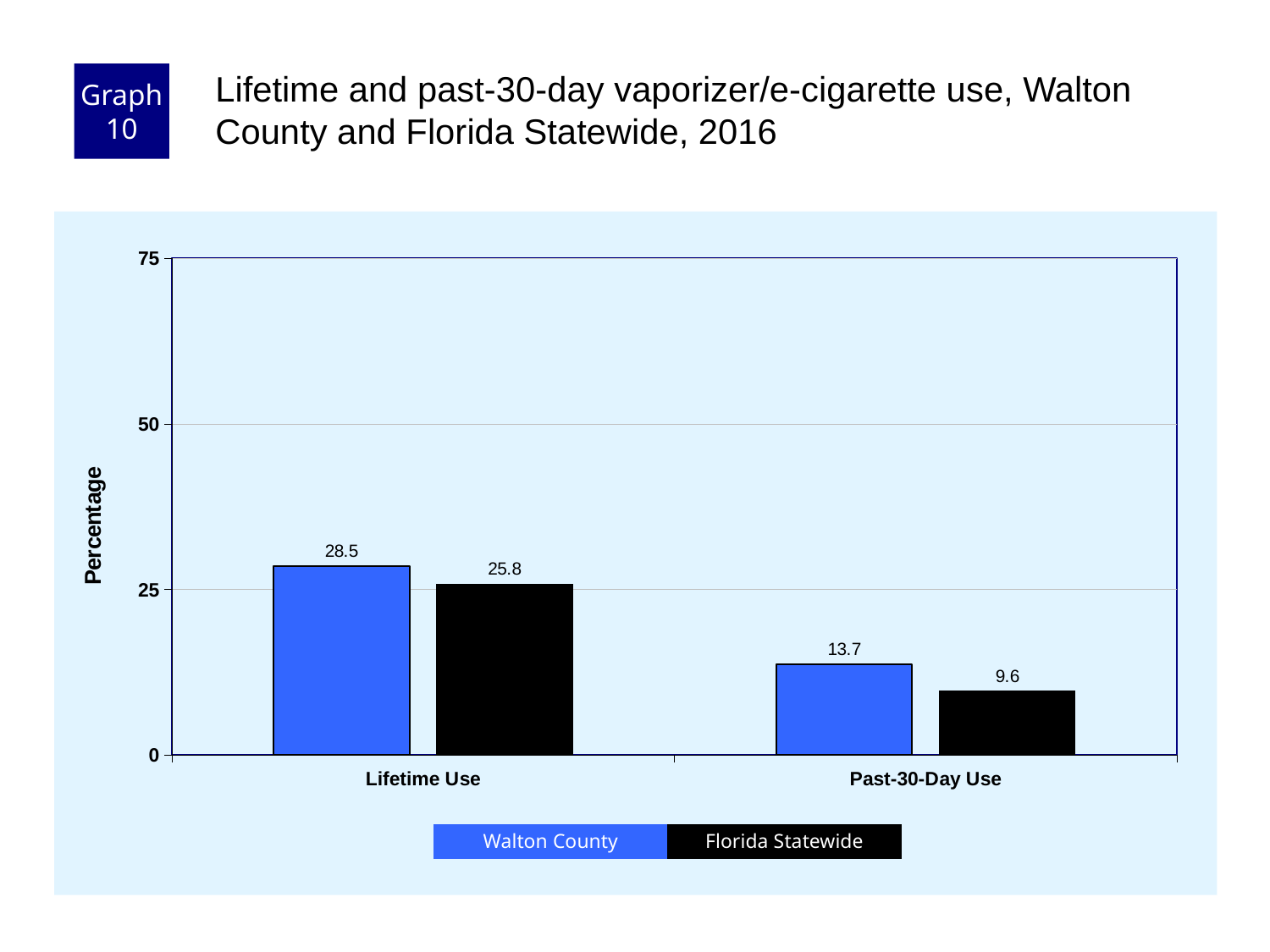
Which bar has the lowest value on the chart? Florida Statewide, Past-30-Day Use Which bar has the highest value on the chart? Walton County, Lifetime Use What is the Walton County value for Lifetime Use? 28.5 What is the Florida Statewide value for Past-30-Day Use? 9.6 For Past-30-Day Use, which is larger: Walton County or Florida Statewide? Walton County What is the difference between the Walton County and Florida Statewide values for Past-30-Day Use? 4.1 What is the Walton County value for Past-30-Day Use? 13.7 How many series does the legend list? 2 How many categories are shown on the x axis? 2 What is the difference between the Walton County and Florida Statewide values for Lifetime Use? 2.7 What kind of chart is shown on the slide? Bar chart Is the Florida Statewide value for Lifetime Use greater or less than 25? greater